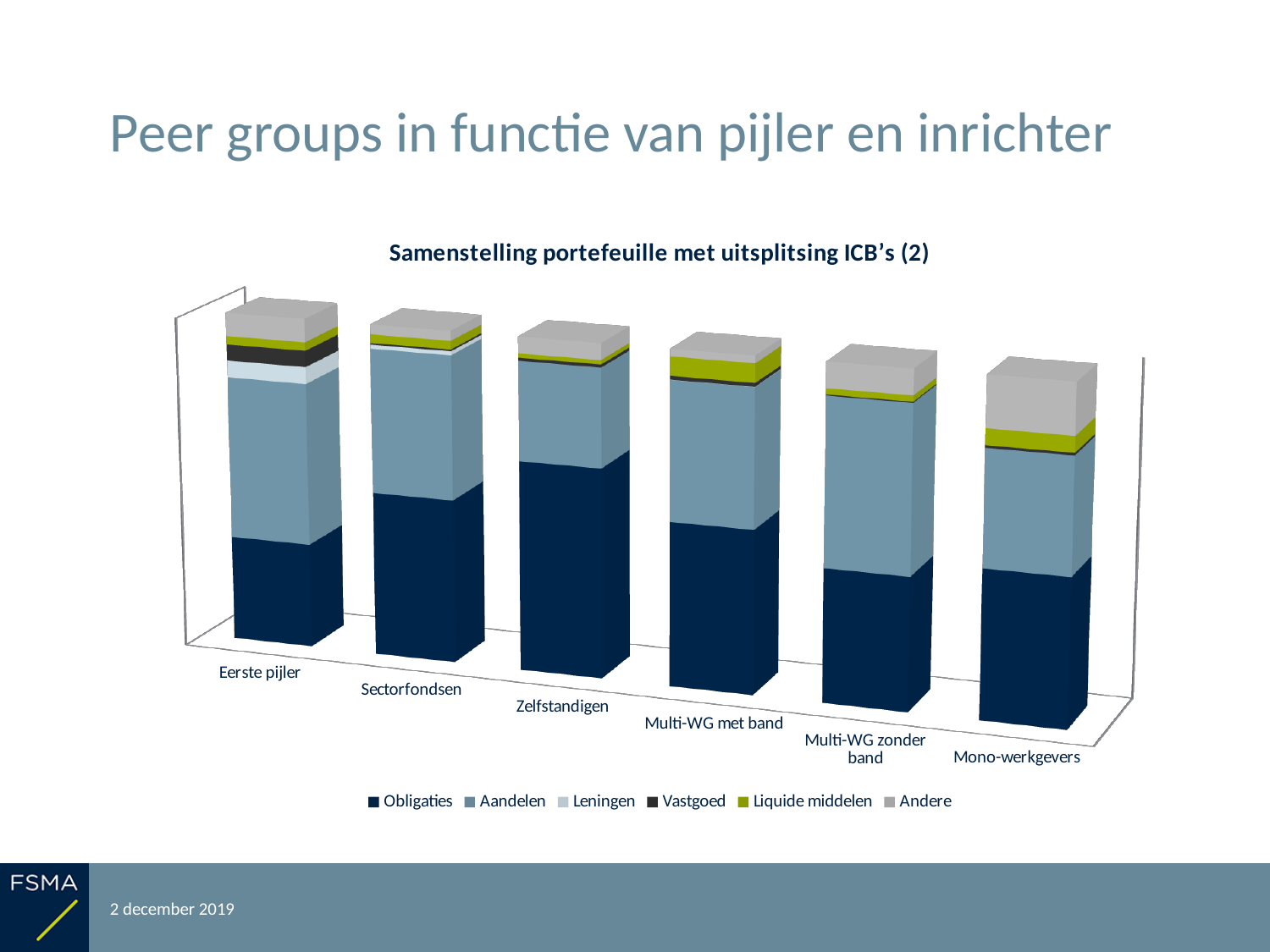
Which category has the largest Andere segment? Mono-werkgevers Which series is listed first in the chart's legend? Obligaties Is the Aandelen segment larger for Eerste pijler or for Zelfstandigen? Eerste pijler Which category has the largest Obligaties segment? Zelfstandigen Which category has the smallest Obligaties segment? Eerste pijler Is the Liquide middelen segment larger for Multi-WG met band or for Sectorfondsen? Multi-WG met band What kind of chart is shown on the slide? Stacked bar chart Is the Obligaties segment larger for Zelfstandigen or for Eerste pijler? Zelfstandigen How many categories (peer groups) are shown along the x axis of the chart? 6 How many series does the chart's legend list? 6 What is the title of the chart? Samenstelling portefeuille met uitsplitsing ICB's (2)